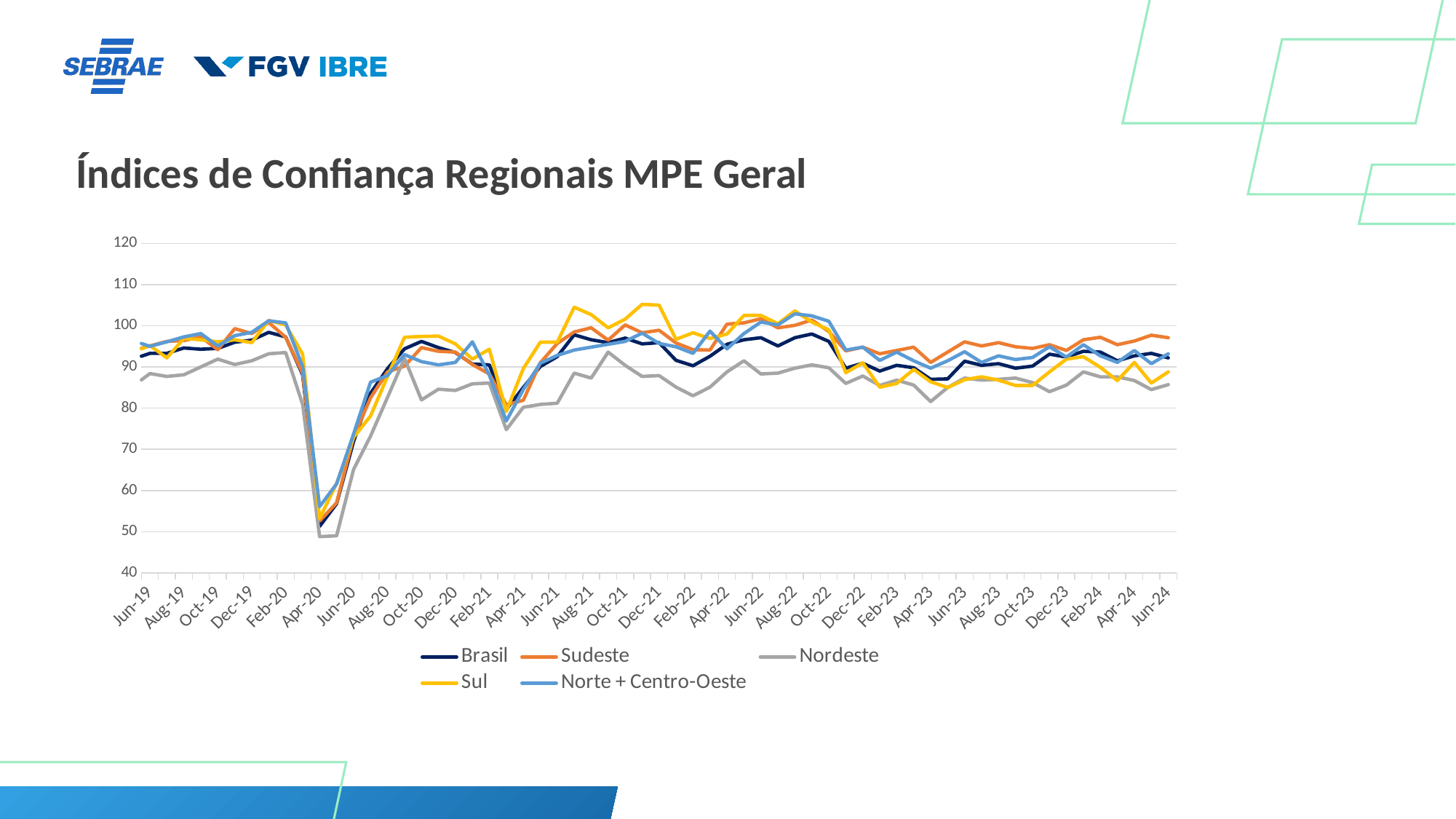
Which is larger in Jun-19, the value for Brasil or the value for Nordeste? Brasil What is the title of the chart? Índices de Confiança Regionais MPE Geral What colour is the Nordeste line in the legend? gray How many series does the legend list? 5 What kind of chart is shown on the slide? line chart Do the values for Brasil rise or fall from Feb-20 to Apr-20? fall Which series is lowest in Apr-20? Nordeste Is the value for Nordeste in Jun-19 greater or less than 90? less Is the value for Sul in Aug-21 greater or less than 100? greater Is the value for Nordeste in Apr-20 greater or less than 60? less Which series is highest in Aug-21? Sul